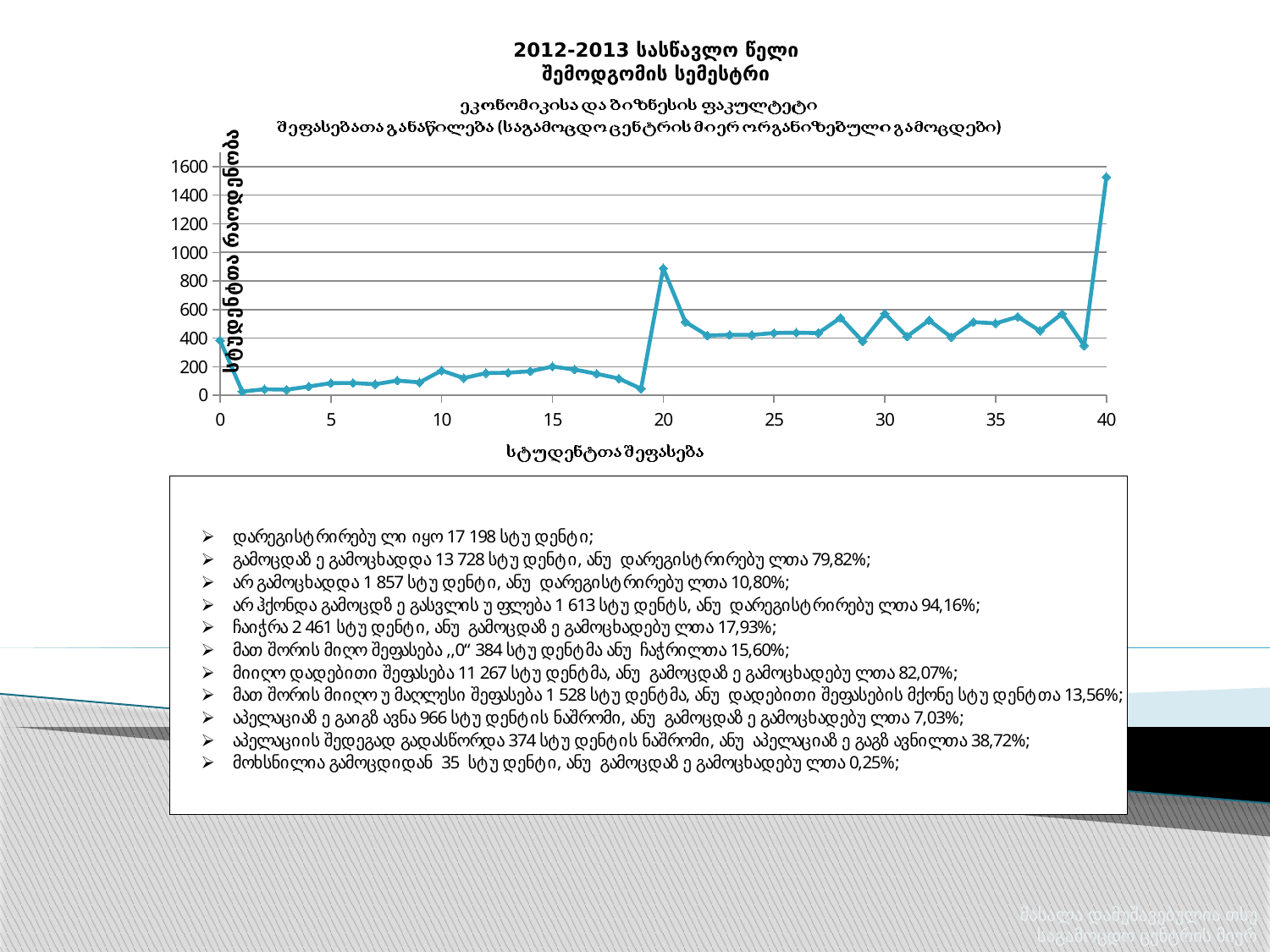
Is the number of students at score 20 greater or less than 1000? less What is the title of the x-axis? სტუდენტთა შეფასება What kind of chart is shown on the slide? line chart Which has more students: score 10 or score 30? 30 Is the number of students at score 20 greater or less than 800? greater Is the number of students at score 40 greater or less than 1400? greater What is the highest value shown on the y-axis? 1600 Does the number of students rise or fall between score 19 and score 20? rise At which student score (x-axis value) does the line reach its highest number of students? 40 Which has more students: score 20 or score 40? 40